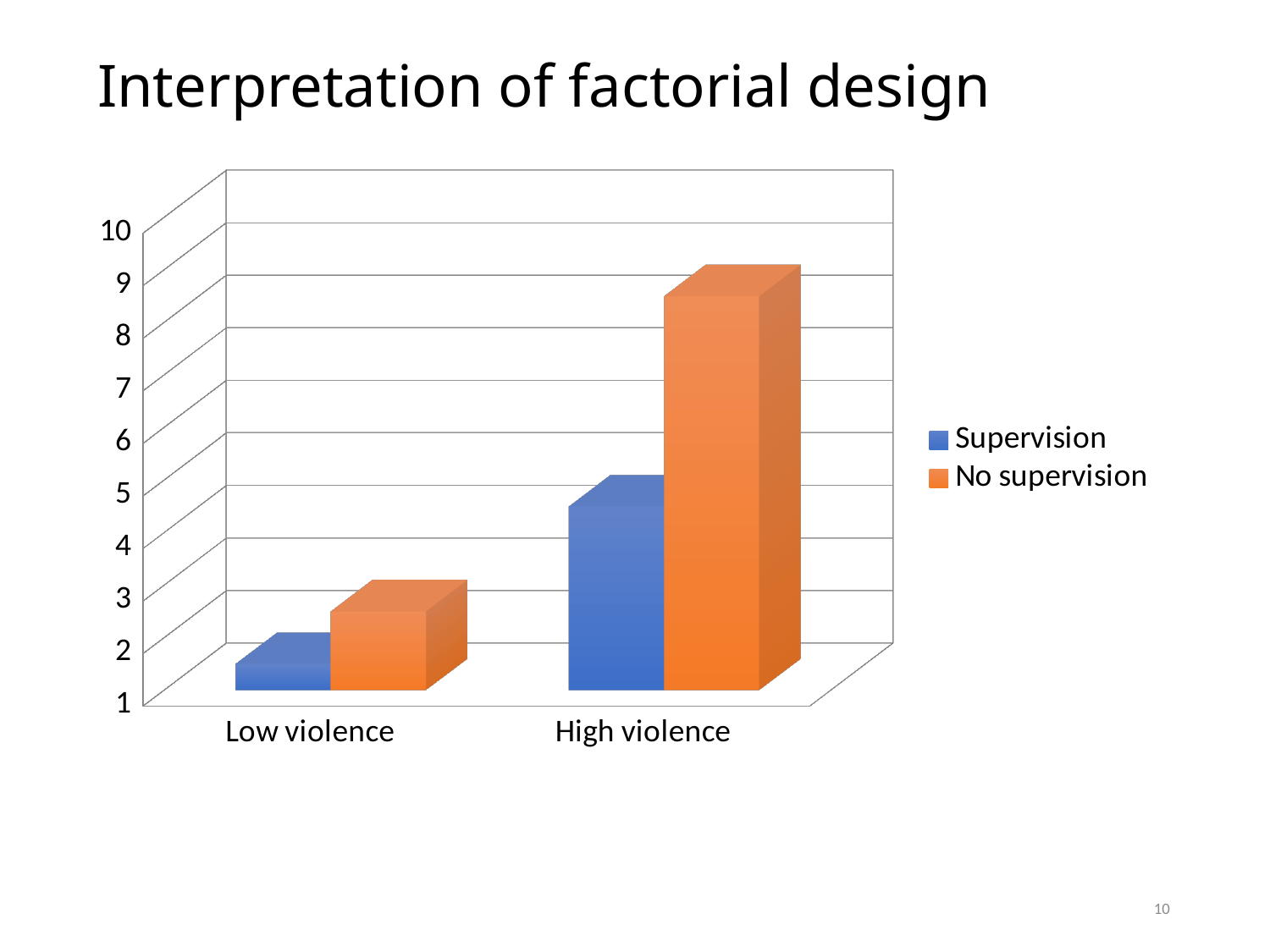
Is the value for No supervision in the High violence category greater or less than 8? greater What kind of chart is shown on the slide? bar chart How many categories are shown on the x axis? 2 Do the values for the Supervision series rise or fall from Low violence to High violence? rise Is the value for No supervision in the Low violence category greater or less than 2? greater Which category and series combination has the lowest bar? Low violence, Supervision Which colour represents the No supervision series? orange Which category and series combination has the highest bar? High violence, No supervision Which is larger in the High violence category, Supervision or No supervision? No supervision Is the value for Supervision in the High violence category greater or less than 4? greater How many series does the legend list? 2